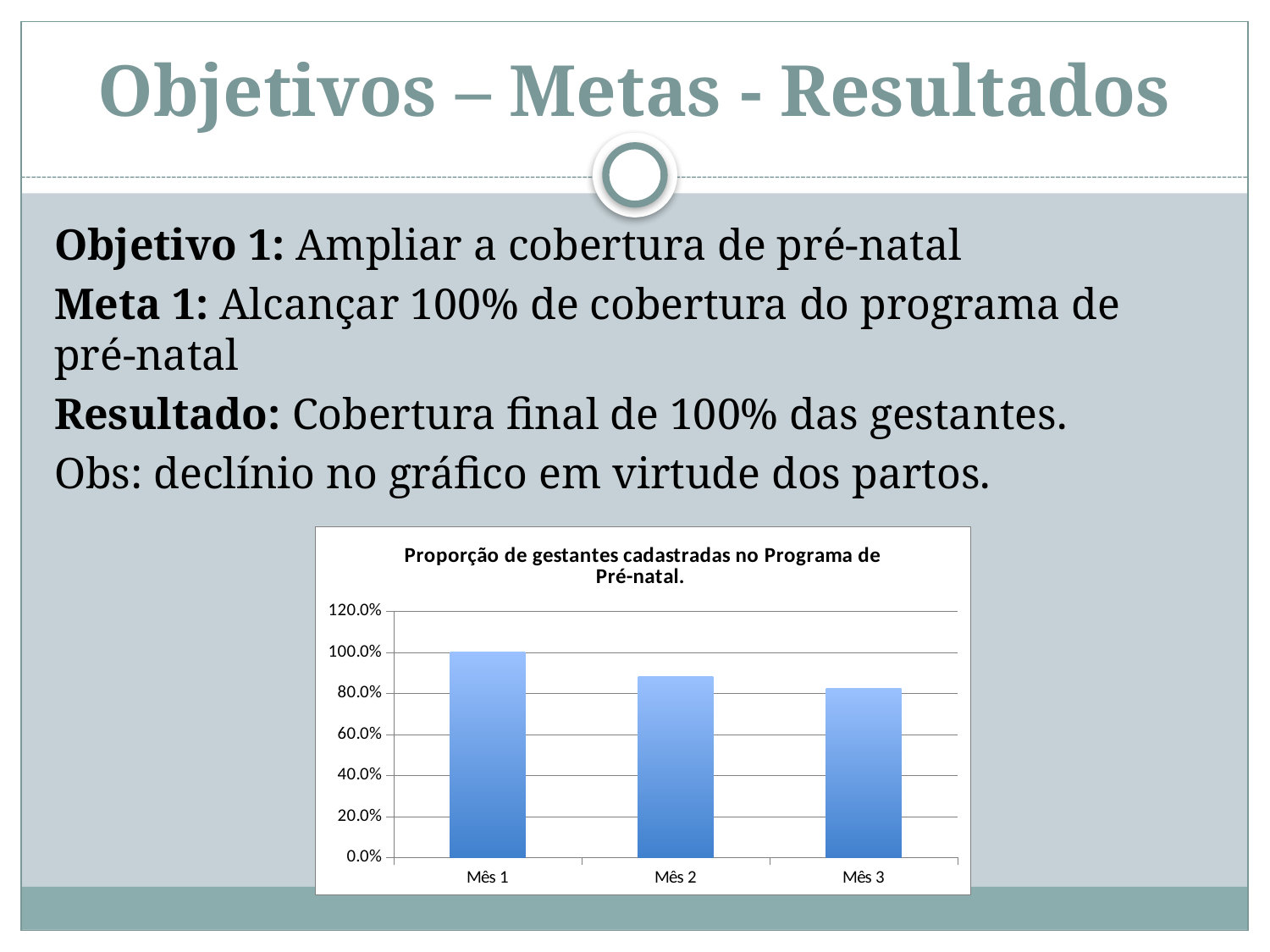
Which is larger, the value for Mês 2 or the value for Mês 3? Mês 2 Is the value for Mês 2 greater or less than 100.0%? less What is the highest value shown on the vertical axis? 120.0% What kind of chart is shown on the slide? bar chart Is the value for Mês 2 greater or less than 80.0%? greater What is the title of the chart? Proporção de gestantes cadastradas no Programa de Pré-natal. Is the value for Mês 3 greater or less than 100.0%? less What is the value for Mês 1? 100.0% Do the values rise or fall from Mês 1 to Mês 3? fall Which month has the lowest value? Mês 3 How many categories (months) are plotted on the chart? 3 Which month has the highest value? Mês 1